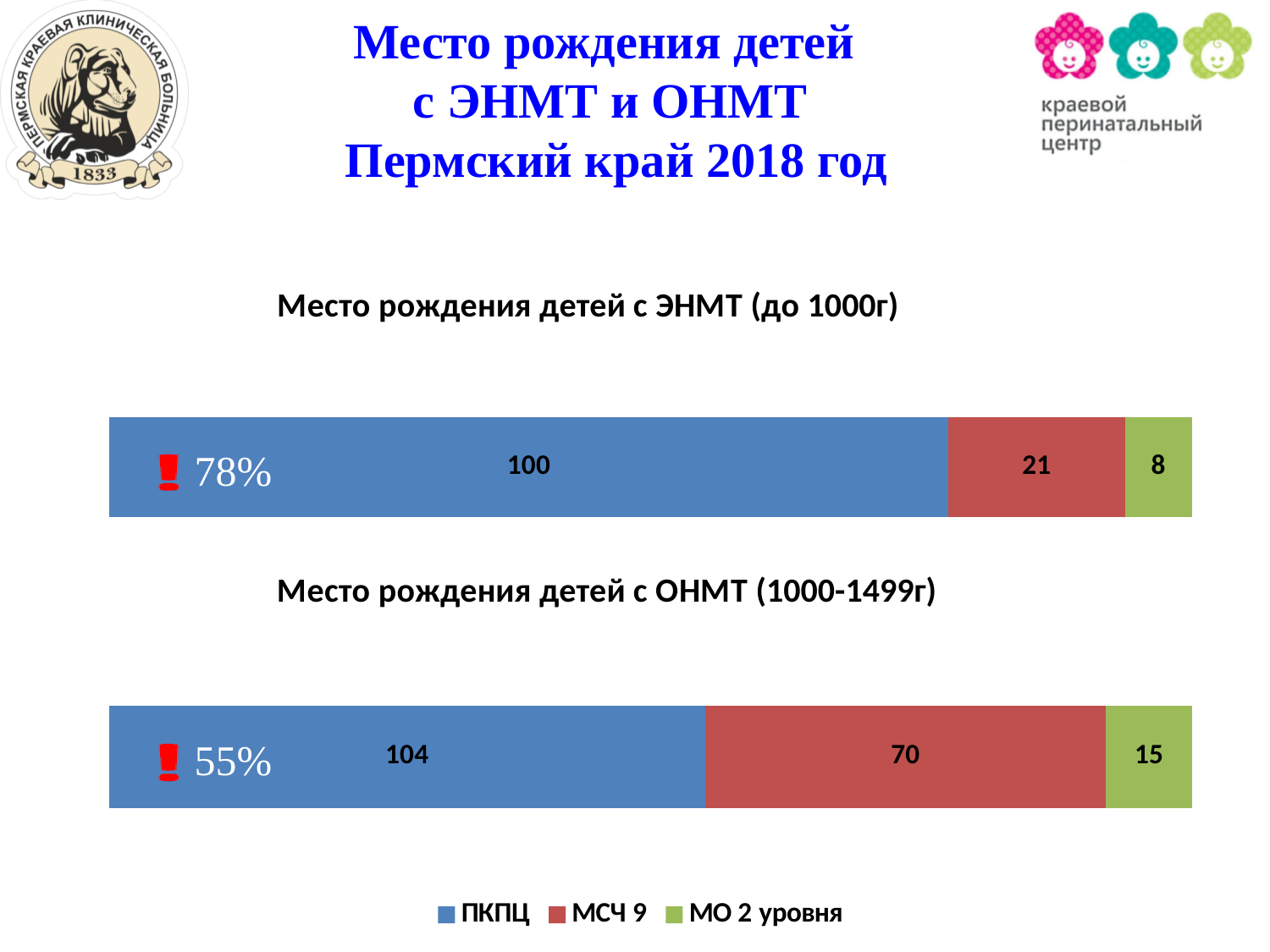
In the chart 'Место рождения детей с ОНМТ (1000-1499г)', which series has the highest value? ПКПЦ In the chart 'Место рождения детей с ЭНМТ (до 1000г)', what is the value for ПКПЦ? 100 How many series does the legend at the bottom of the slide list? 3 In the chart 'Место рождения детей с ЭНМТ (до 1000г)', which series has the lowest value? МО 2 уровня In the chart 'Место рождения детей с ОНМТ (1000-1499г)', what is the value for МСЧ 9? 70 In the chart 'Место рождения детей с ОНМТ (1000-1499г)', what is the total of the stacked bar? 189 In the chart 'Место рождения детей с ЭНМТ (до 1000г)', what is the value for МСЧ 9? 21 Which is larger: the value for МСЧ 9 in the ЭНМТ chart or the value for МСЧ 9 in the ОНМТ chart? ОНМТ chart What type of chart is 'Место рождения детей с ОНМТ (1000-1499г)'? Stacked bar chart In the chart 'Место рождения детей с ЭНМТ (до 1000г)', what is the total of the stacked bar? 129 In the chart 'Место рождения детей с ОНМТ (1000-1499г)', what is the value for МО 2 уровня? 15 In the chart 'Место рождения детей с ЭНМТ (до 1000г)', what is the difference between the values for ПКПЦ and МСЧ 9? 79